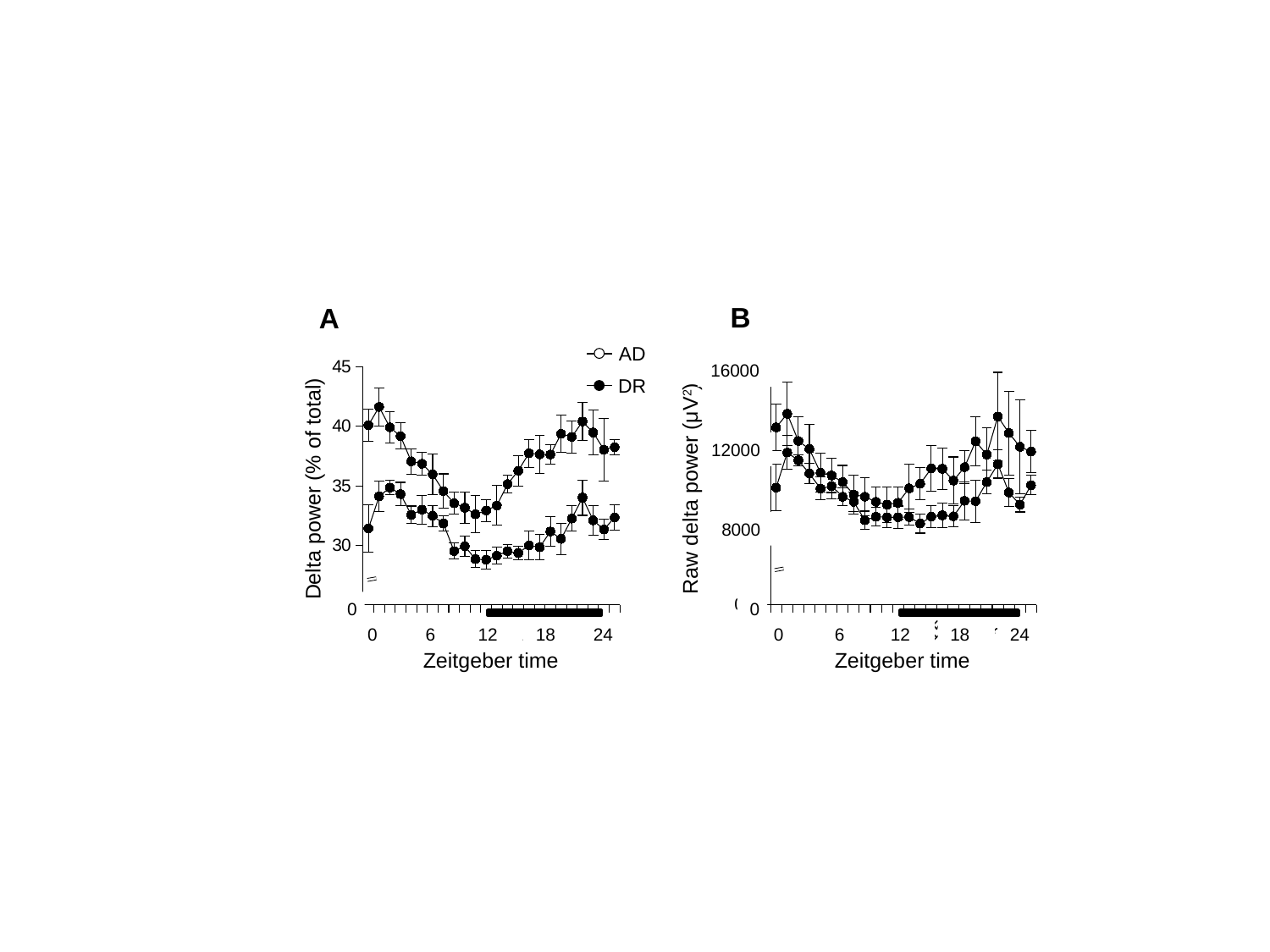
In chart A, is the value of the upper line at Zeitgeber time 24 greater or less than 35? greater What are the two series named in the legend? AD and DR In chart B, is the value of the lower line at Zeitgeber time 12 greater or less than 12000? less How many series does the legend list? 2 In chart B, is the value of the upper line at Zeitgeber time 1 greater or less than 12000? greater In chart A, which line is higher at Zeitgeber time 0, the upper line or the lower line? the upper line What kind of chart is chart A? line chart In chart A, does the upper line rise or fall between Zeitgeber time 12 and Zeitgeber time 24? rise In chart A, does the upper line rise or fall between Zeitgeber time 0 and Zeitgeber time 12? fall What is the y-axis title of chart B? Raw delta power (μV²)